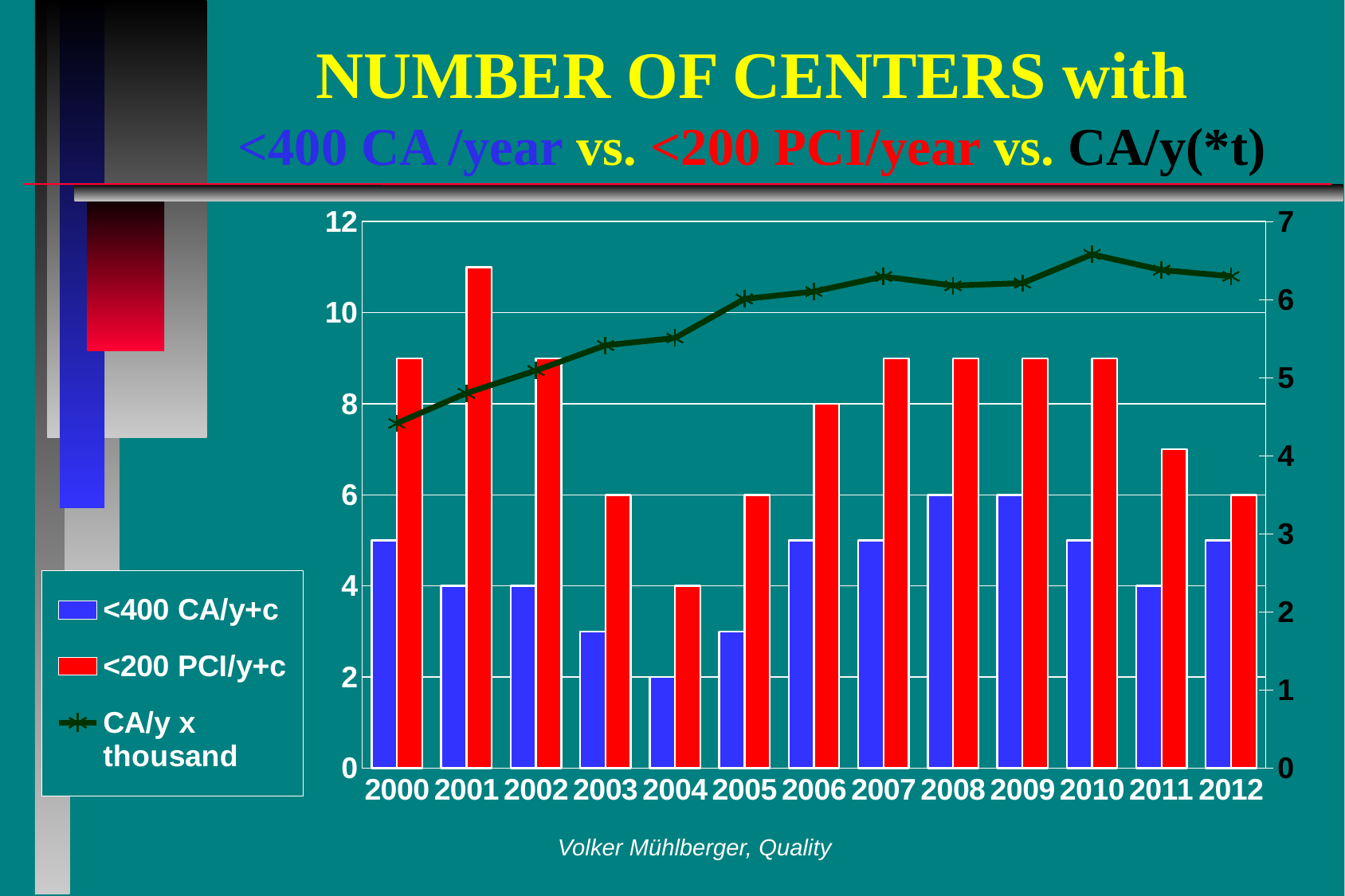
In which year is the <200 PCI/y+c bar highest? 2001 In 2000, which is larger: the <400 CA/y+c bar or the <200 PCI/y+c bar? <200 PCI/y+c Does the CA/y x thousand line generally rise or fall from 2000 to 2012? rise In which year is the <400 CA/y+c bar lowest? 2004 What is the value of the <200 PCI/y+c series in 2006? 8 What kind of chart is shown on the slide? bar chart with a line Is the <200 PCI/y+c value for 2001 greater or less than 10? greater What is the value of the <400 CA/y+c series in 2004? 2 Is the CA/y x thousand value for 2000 greater or less than 5 on the right axis? less What is the difference between the <200 PCI/y+c and <400 CA/y+c values in 2004? 2 How many years are shown on the x axis? 13 How many series does the legend list? 3